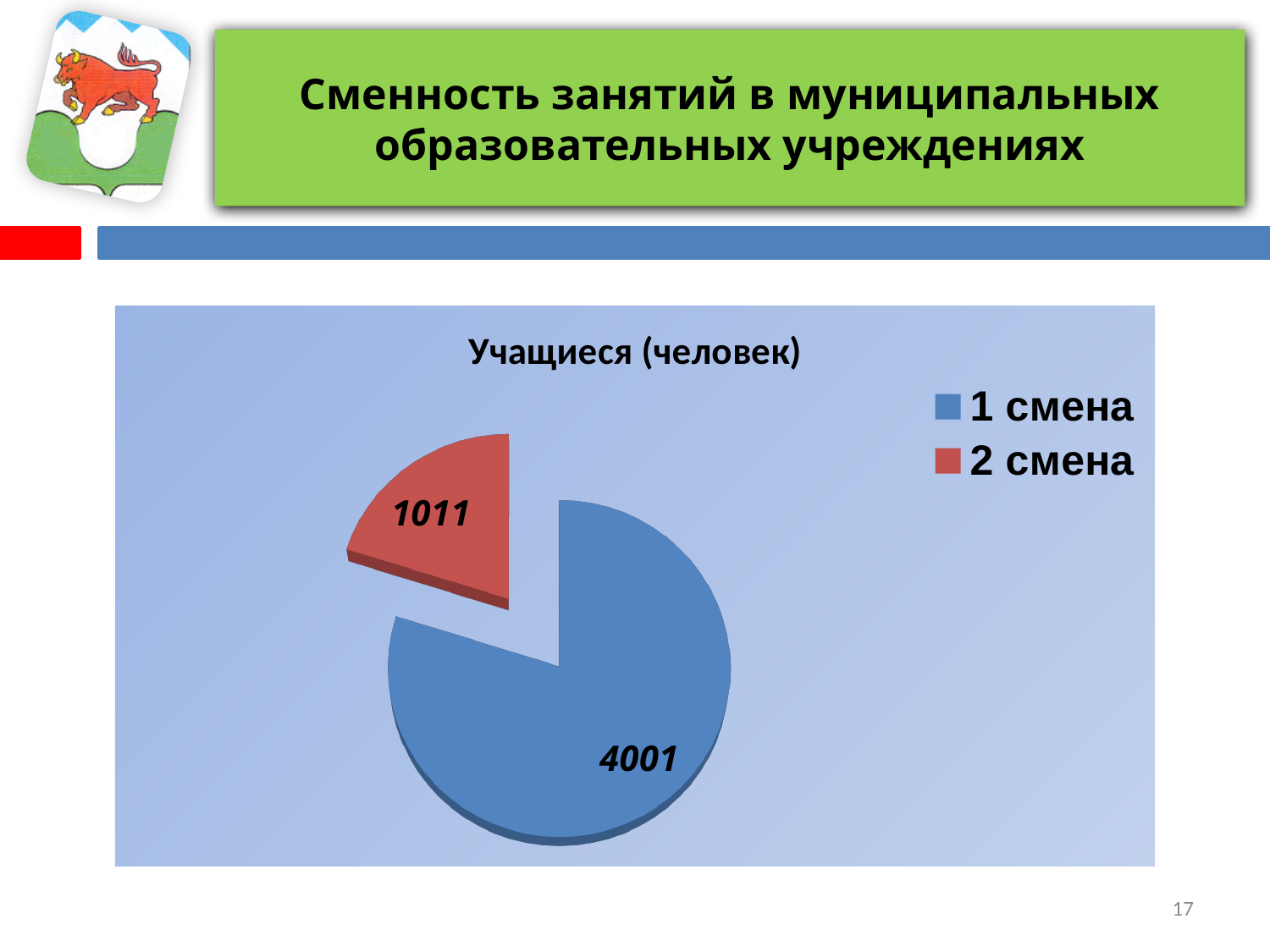
Which category has the largest slice of the pie? 1 смена How many entries does the chart legend list? 2 Which colour represents "2 смена" in the chart? red Which is larger, the value for "1 смена" or the value for "2 смена"? 1 смена Which category has the smallest slice of the pie? 2 смена What is the title of the chart? Учащиеся (человек) What is the value for "2 смена"? 1011 What is the difference between the values for "1 смена" and "2 смена"? 2990 How many slices does the pie chart have? 2 What is the value for "1 смена"? 4001 What kind of chart is shown on the slide? pie chart What is the total of the two slices in the pie chart? 5012